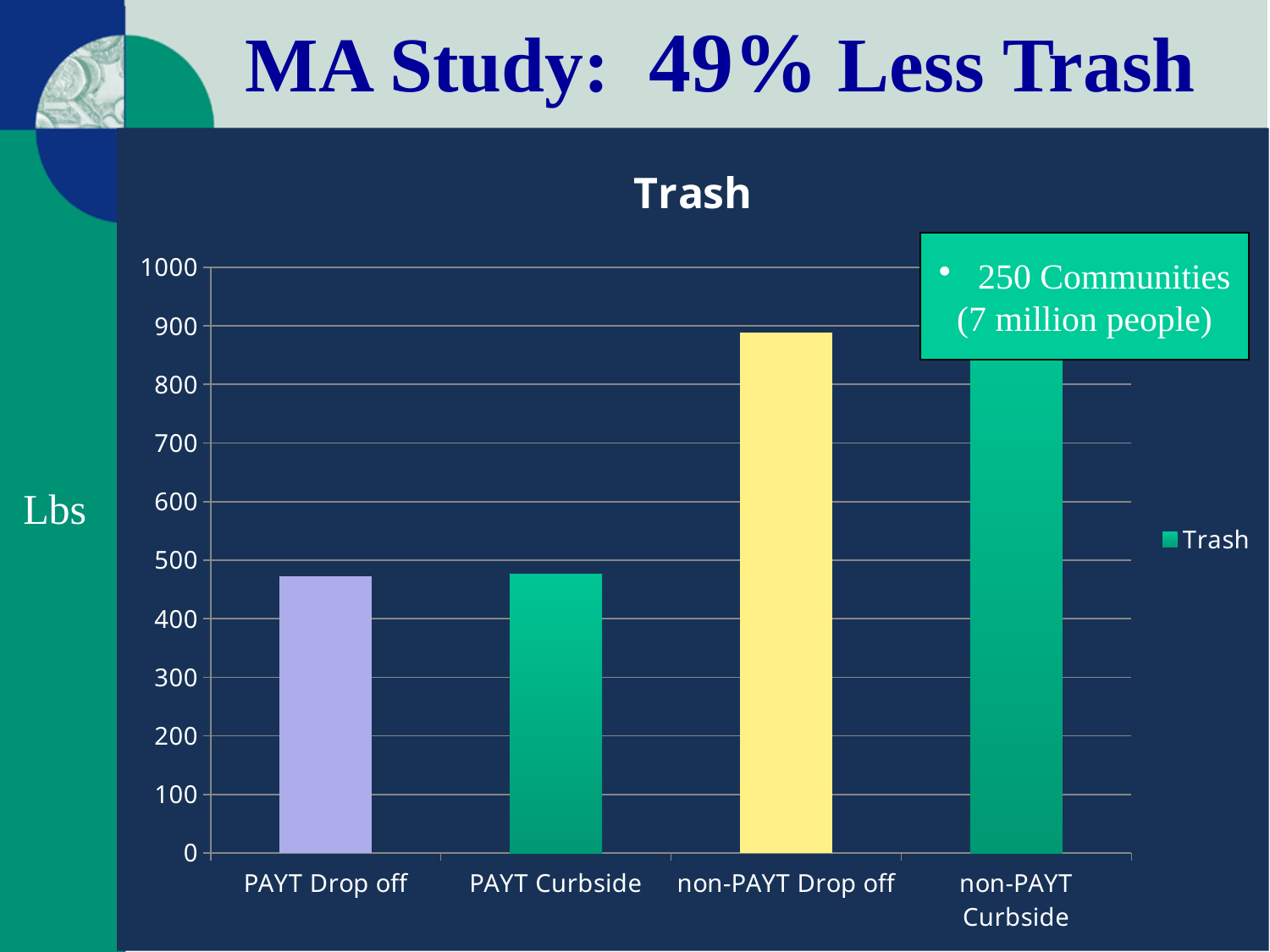
What is the title of the chart? Trash Is the value for non-PAYT Drop off greater or less than 800? greater How many series does the chart's legend list? 1 Is the value for PAYT Curbside greater or less than 500? less Which is larger, the value for PAYT Curbside or the value for non-PAYT Curbside? non-PAYT Curbside Is the value for non-PAYT Curbside greater or less than 800? greater Which is larger, the value for non-PAYT Drop off or the value for PAYT Drop off? non-PAYT Drop off What unit label is shown beside the vertical axis of the chart? Lbs How many categories are shown on the x axis of the chart? 4 What kind of chart is shown on the slide? bar chart